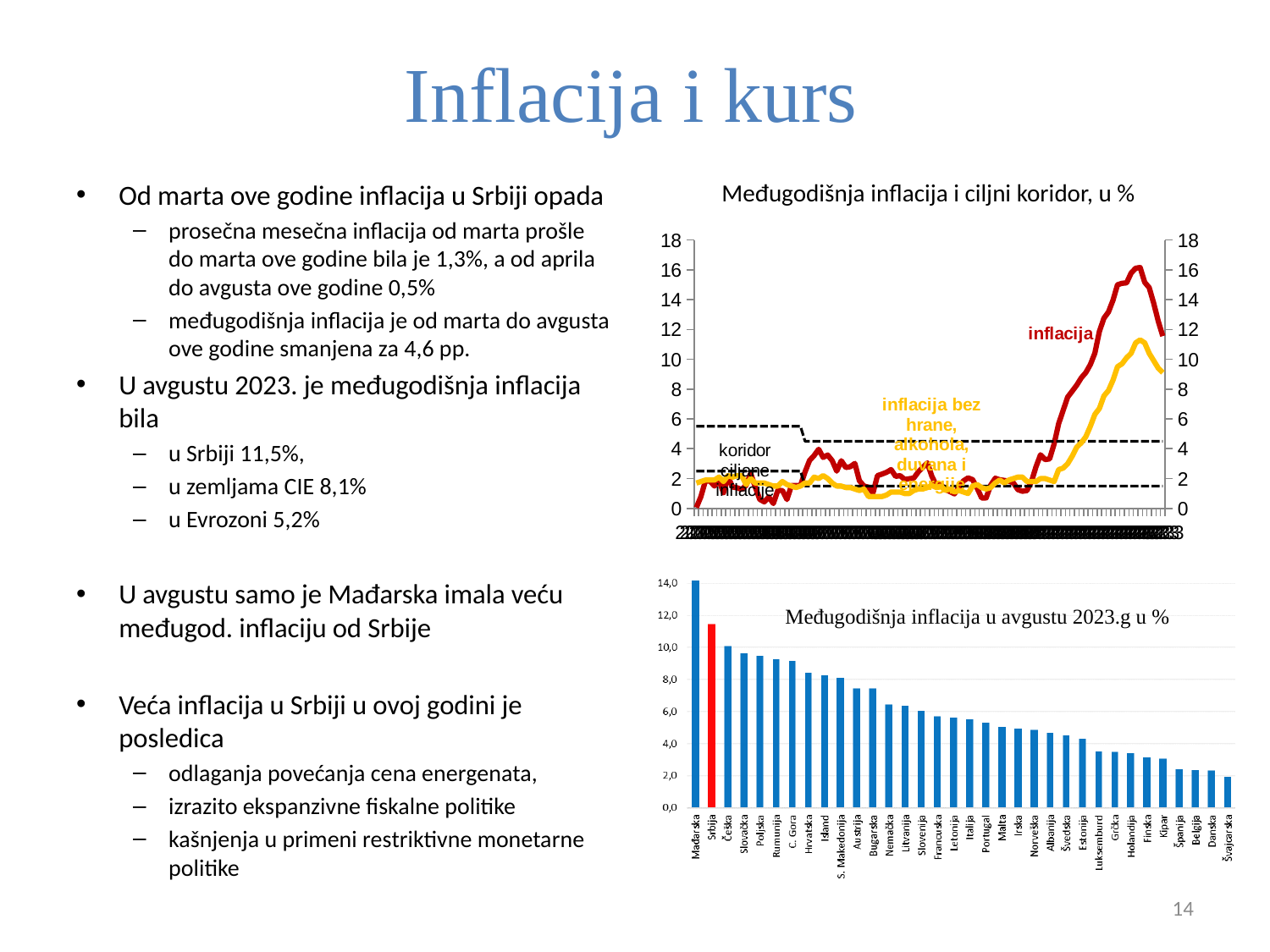
In the bottom bar chart, which has the larger value, Poljska or Hrvatska? Poljska In the bottom bar chart, which bar is coloured red? Srbija In the bottom bar chart, which country has the lowest inflation in August 2023? Švajcarska In the bottom bar chart, is the value for Srbija greater or less than 10,0? greater How many countries are shown in the bottom bar chart? 34 In the bottom bar chart, which country has the highest inflation in August 2023? Mađarska What kind of chart is the bottom chart titled 'Međugodišnja inflacija u avgustu 2023.g u %'? bar chart In the bottom bar chart, is the value for Mađarska greater or less than 12,0? greater In the top line chart, what is the maximum value shown on the vertical axis? 18 In the bottom bar chart, is the value for Švajcarska greater or less than 4,0? less What kind of chart is the top chart titled 'Međugodišnja inflacija i ciljni koridor, u %'? line chart